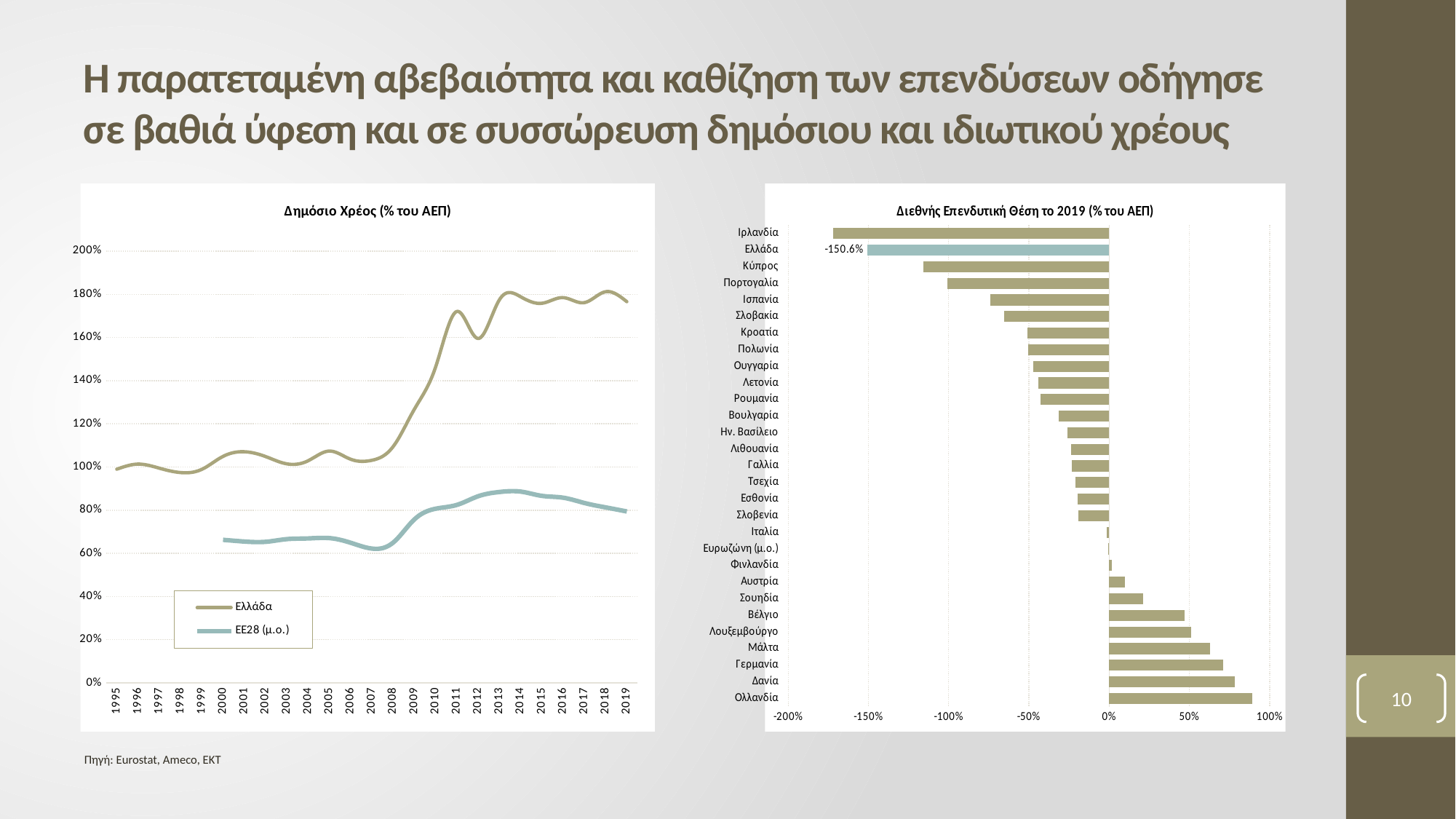
How many series does the legend of the chart titled 'Δημόσιο Χρέος (% του ΑΕΠ)' list? 2 How many countries/categories are listed in the chart titled 'Διεθνής Επενδυτική Θέση το 2019 (% του ΑΕΠ)'? 29 In the chart titled 'Διεθνής Επενδυτική Θέση το 2019 (% του ΑΕΠ)', which country has the lowest (most negative) value? Ιρλανδία In the chart titled 'Δημόσιο Χρέος (% του ΑΕΠ)', does the Ελλάδα series rise or fall between 2008 and 2011? Rise What kind of chart is the one titled 'Διεθνής Επενδυτική Θέση το 2019 (% του ΑΕΠ)'? Bar chart What kind of chart is the one titled 'Δημόσιο Χρέος (% του ΑΕΠ)'? Line chart In the chart titled 'Διεθνής Επενδυτική Θέση το 2019 (% του ΑΕΠ)', what value is labelled for Ελλάδα? -150.6% In the chart titled 'Διεθνής Επενδυτική Θέση το 2019 (% του ΑΕΠ)', which has the larger value, Ολλανδία or Δανία? Ολλανδία In the chart titled 'Διεθνής Επενδυτική Θέση το 2019 (% του ΑΕΠ)', which country has the highest value? Ολλανδία In the chart titled 'Δημόσιο Χρέος (% του ΑΕΠ)', is the value for Ελλάδα in 2019 greater or less than 160%? greater In the chart titled 'Διεθνής Επενδυτική Θέση το 2019 (% του ΑΕΠ)', is the value for Γερμανία greater or less than 50%? greater In the chart titled 'Διεθνής Επενδυτική Θέση το 2019 (% του ΑΕΠ)', is the value for Κύπρος greater or less than -100%? less